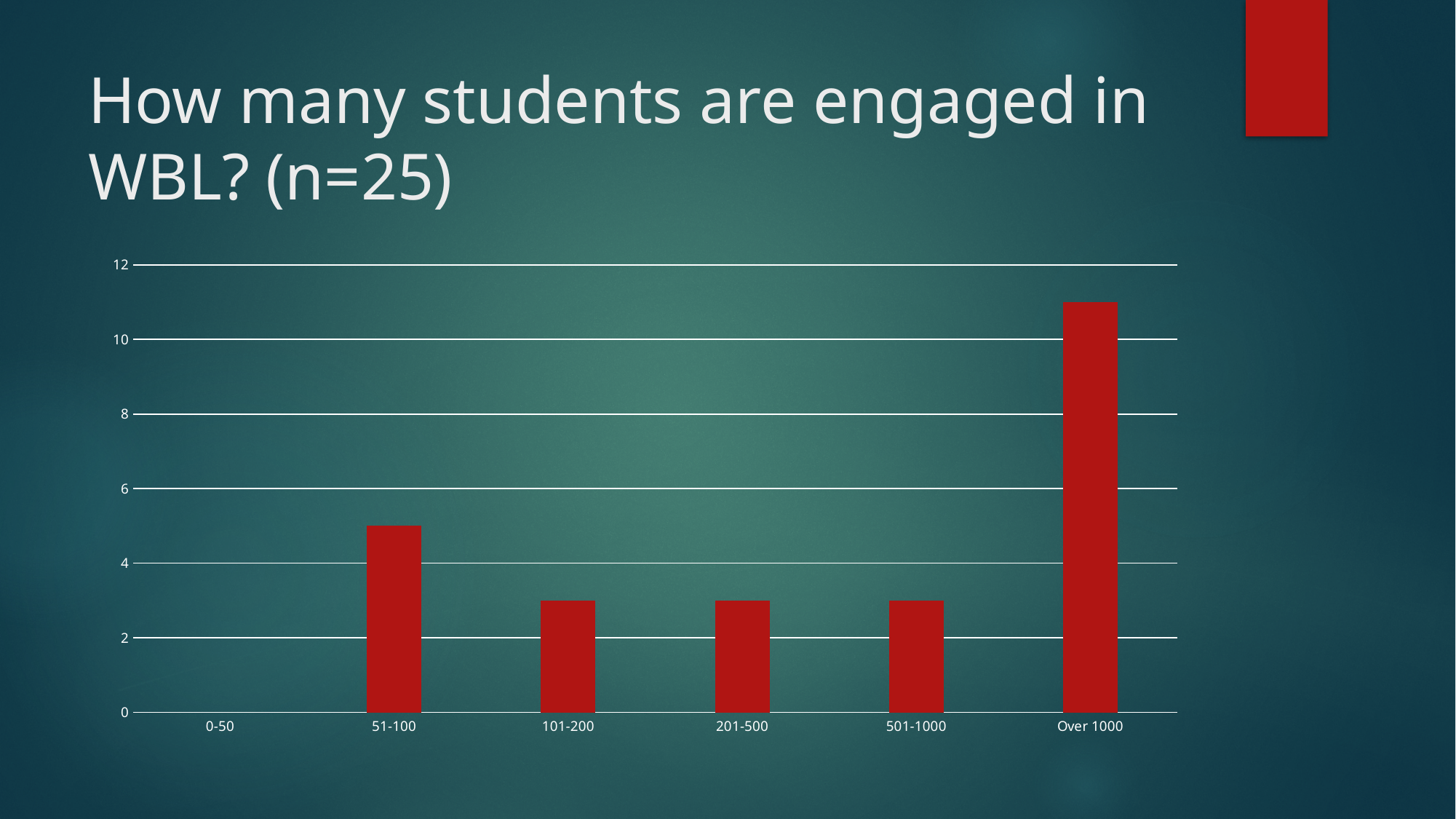
What kind of chart is shown on the slide? bar chart Is the value for 501-1000 greater or less than 2? greater Which is larger, the value for Over 1000 or the value for 51-100? Over 1000 Which category has the lowest value? 0-50 Which is larger, the value for 51-100 or the value for 201-500? 51-100 Is the value for 101-200 greater or less than 4? less How many categories are shown on the x axis of the chart? 6 Is the value for 51-100 greater or less than 4? greater Which category has the highest bar? Over 1000 What is the title of the chart's slide? How many students are engaged in WBL? (n=25) What colour are the bars in the chart? red